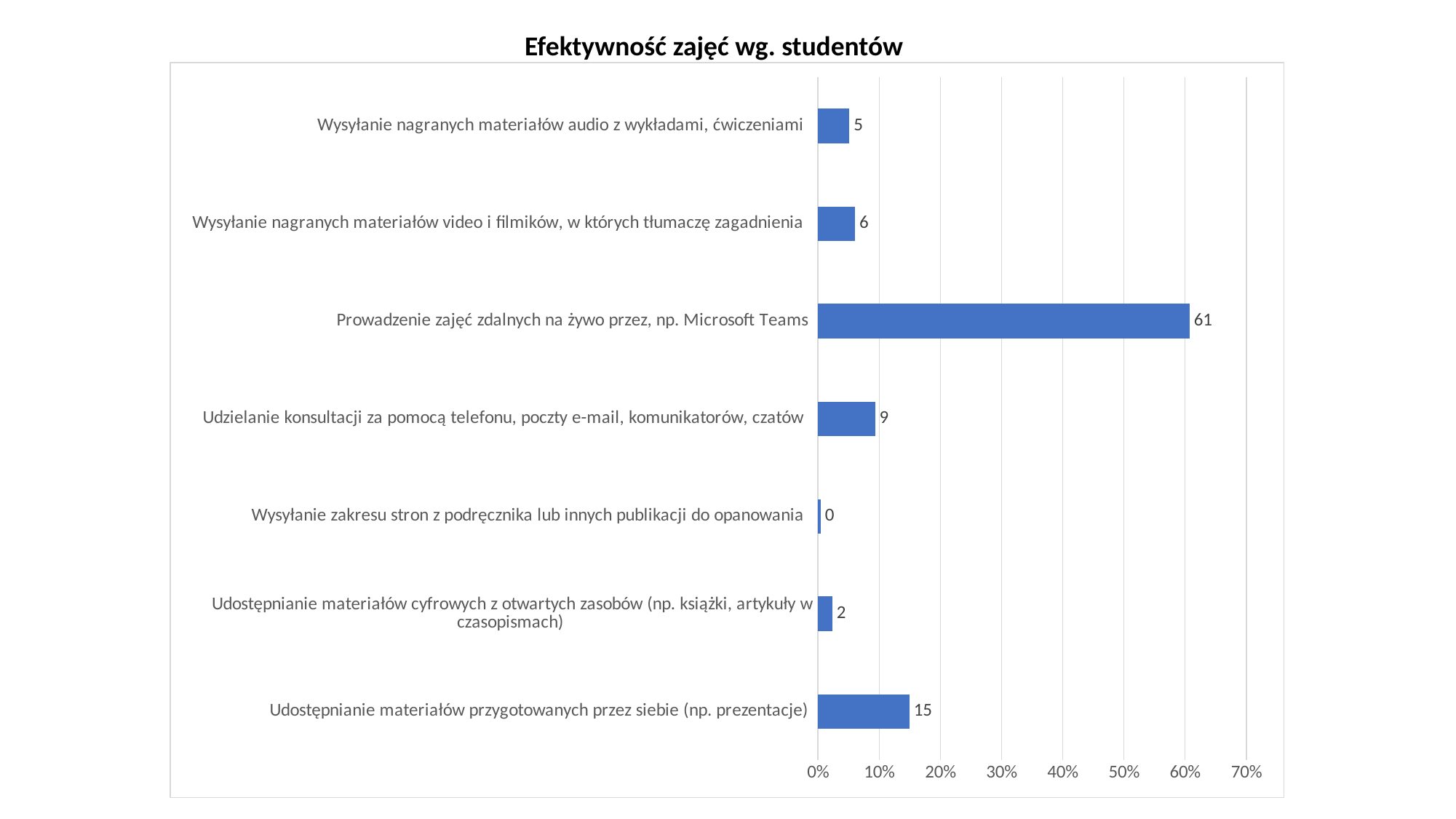
What is the value for "Udzielanie konsultacji za pomocą telefonu, poczty e-mail, komunikatorów, czatów"? 9 Is the value for "Prowadzenie zajęć zdalnych na żywo przez, np. Microsoft Teams" greater or less than 50%? greater Which is larger: the value for "Wysyłanie nagranych materiałów audio z wykładami, ćwiczeniami" or for "Wysyłanie nagranych materiałów video i filmików, w których tłumaczę zagadnienia"? Wysyłanie nagranych materiałów video i filmików, w których tłumaczę zagadnienia What is the difference between the values for "Prowadzenie zajęć zdalnych na żywo przez, np. Microsoft Teams" and "Udostępnianie materiałów przygotowanych przez siebie (np. prezentacje)"? 46 What is the value for "Prowadzenie zajęć zdalnych na żywo przez, np. Microsoft Teams"? 61 What is the title of the chart? Efektywność zajęć wg. studentów Which category has the highest value? Prowadzenie zajęć zdalnych na żywo przez, np. Microsoft Teams What is the value for "Udostępnianie materiałów przygotowanych przez siebie (np. prezentacje)"? 15 What is the value for "Wysyłanie zakresu stron z podręcznika lub innych publikacji do opanowania"? 0 How many categories are shown in the chart? 7 Which category has the lowest value? Wysyłanie zakresu stron z podręcznika lub innych publikacji do opanowania What kind of chart is shown on the slide? bar chart